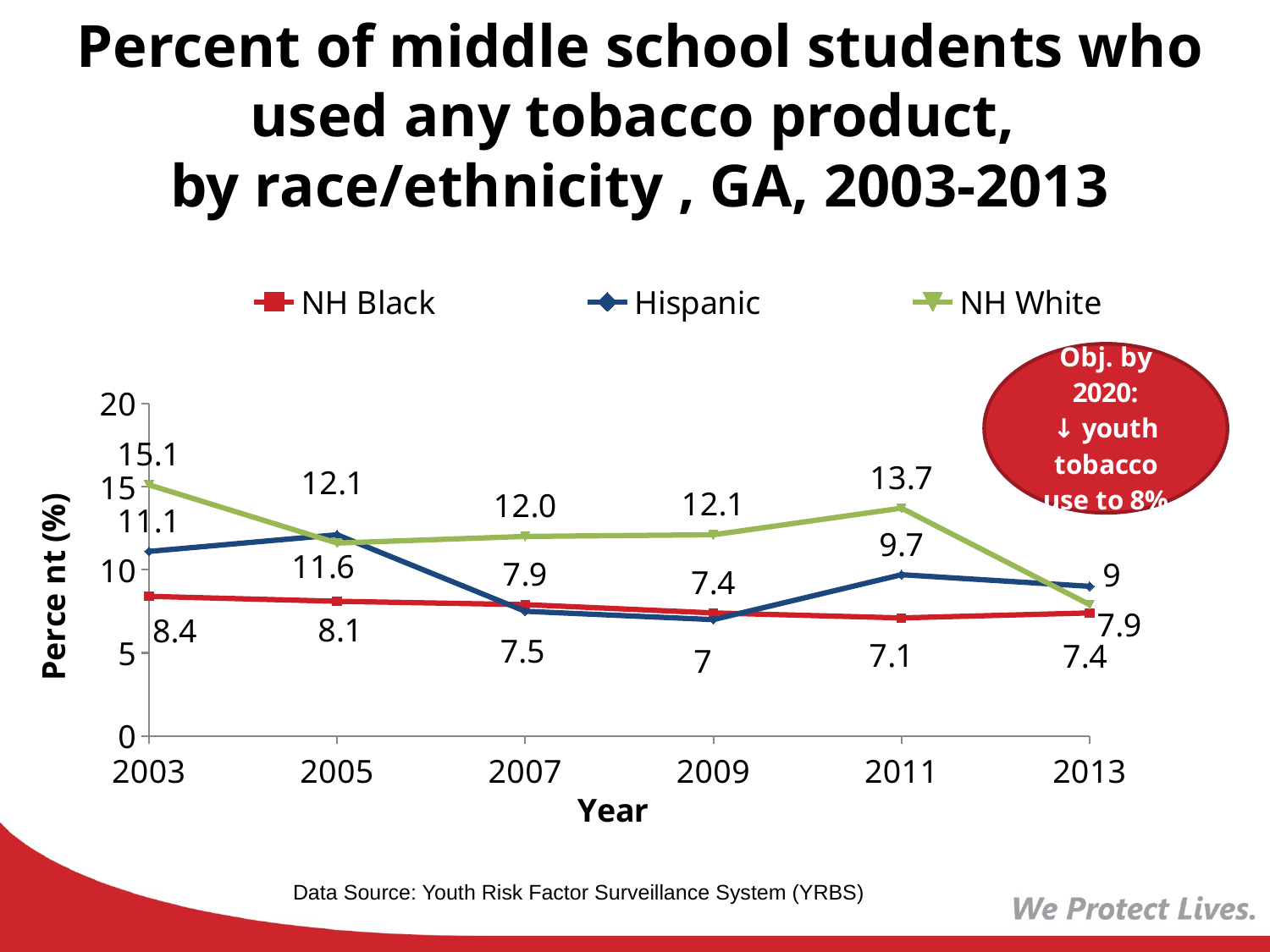
How many years are plotted along the x axis? 6 What was the value for NH White students in 2011? 13.7 According to the callout on the slide, what is the objective for youth tobacco use by 2020? Reduce youth tobacco use to 8% What kind of chart is shown on the slide? Line chart How many series does the legend list? 3 Which is larger in 2013, the Hispanic value or the NH Black value? Hispanic What is the difference between the NH White and NH Black values in 2011? 6.6 Which race/ethnicity group had the highest percent in 2003? NH White What was the percent of NH White middle school students who used any tobacco product in 2003? 15.1 What was the value for Hispanic students in 2011? 9.7 What was the value for NH Black students in 2003? 8.4 What was the value for Hispanic students in 2013? 9